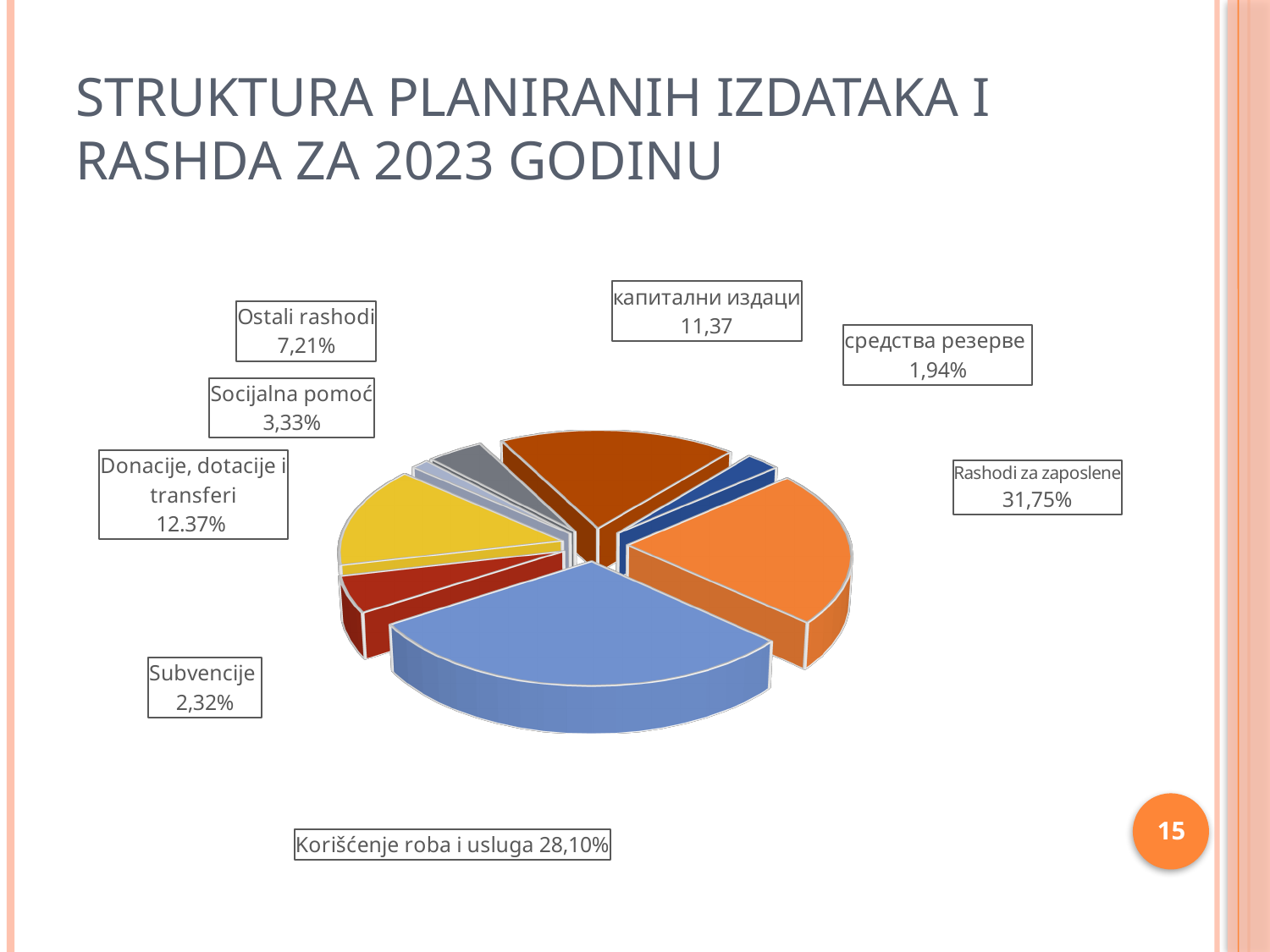
What is the share for Donacije, dotacije i transferi? 12.37% What is the share for Korišćenje roba i usluga? 28,10% How many categories are shown in the pie chart? 8 What is the share for Rashodi za zaposlene? 31,75% What is the share for Subvencije? 2,32% Which is larger, the share for Ostali rashodi or the share for Socijalna pomoć? Ostali rashodi What kind of chart is shown on the slide? Pie chart What is the difference between the shares of Rashodi za zaposlene and Korišćenje roba i usluga? 3,65% What value is shown for капитални издаци? 11,37 What is the share for Socijalna pomoć? 3,33%